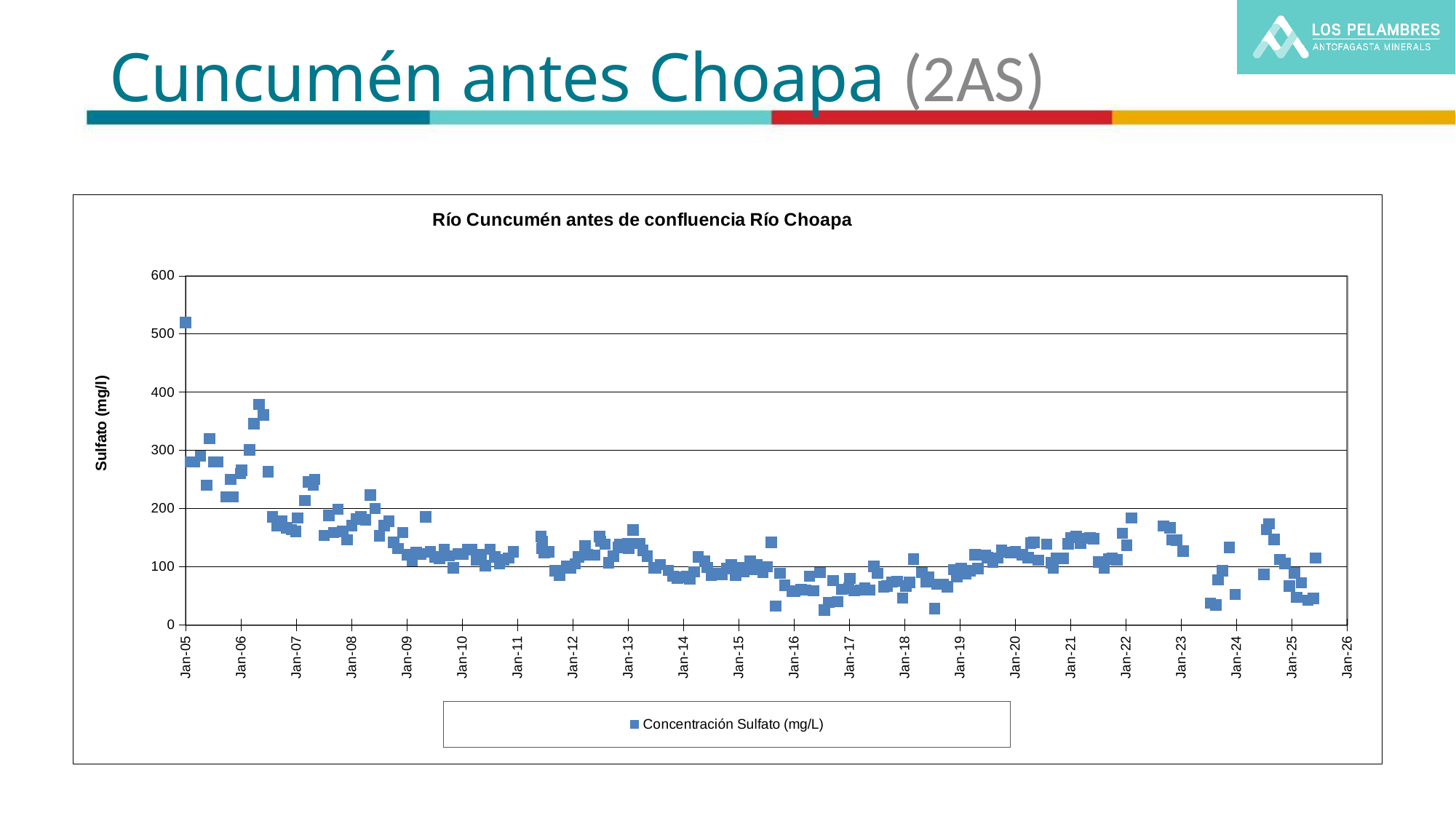
Which period has higher sulfate values, around Jan-06 or around Jan-17? around Jan-06 Is the highest plotted sulfate value greater or less than 500? greater Are the sulfate values plotted around Jan-06 greater or less than 200? greater What kind of chart is shown on the slide? scatter chart Around which x-axis date does the highest sulfate value occur? Jan-05 What is the title of the chart? Río Cuncumén antes de confluencia Río Choapa Are the sulfate values plotted around Jan-21 greater or less than 200? less What is the maximum value shown on the y axis? 600 Overall, do the sulfate values rise or fall from Jan-05 to Jan-25? fall What is the label of the y axis? Sulfato (mg/l) How many series does the legend list? 1